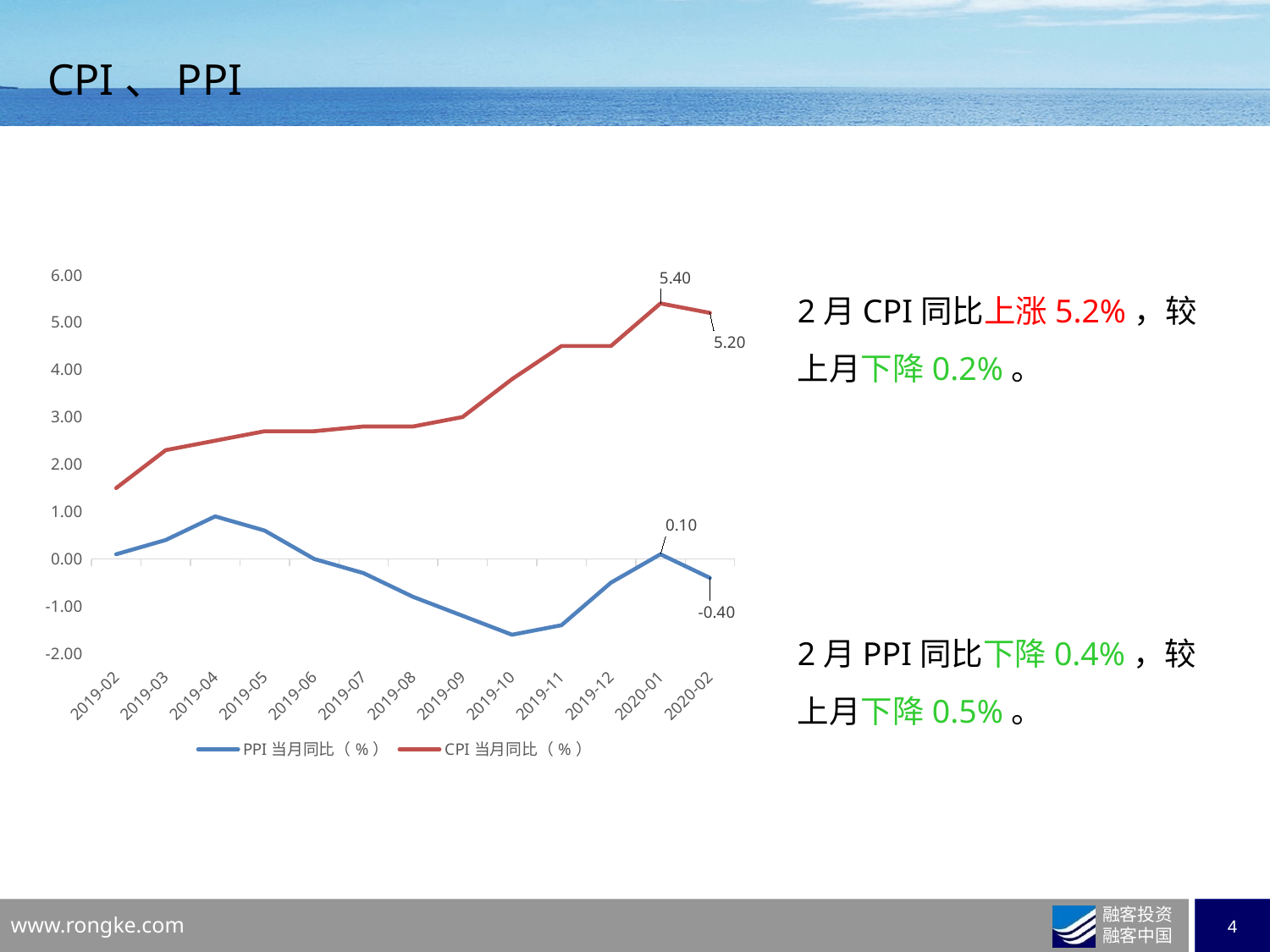
What is the value of CPI 当月同比(%) for 2020-02? 5.20 Which series has the higher value in 2020-02, CPI 当月同比(%) or PPI 当月同比(%)? CPI 当月同比(%) Which colour is used for the CPI 当月同比(%) line? red What is the value of CPI 当月同比(%) for 2020-01? 5.40 How many months are plotted along the x axis? 13 What is the difference between the CPI 当月同比(%) values for 2020-01 and 2020-02? 0.20 What is the value of PPI 当月同比(%) for 2020-01? 0.10 What is the difference between the PPI 当月同比(%) values for 2020-01 and 2020-02? 0.50 How many series does the chart legend list? 2 What type of chart is shown on the slide? line chart Is the value of PPI 当月同比(%) for 2019-10 greater or less than -1.00? less What is the value of PPI 当月同比(%) for 2020-02? -0.40